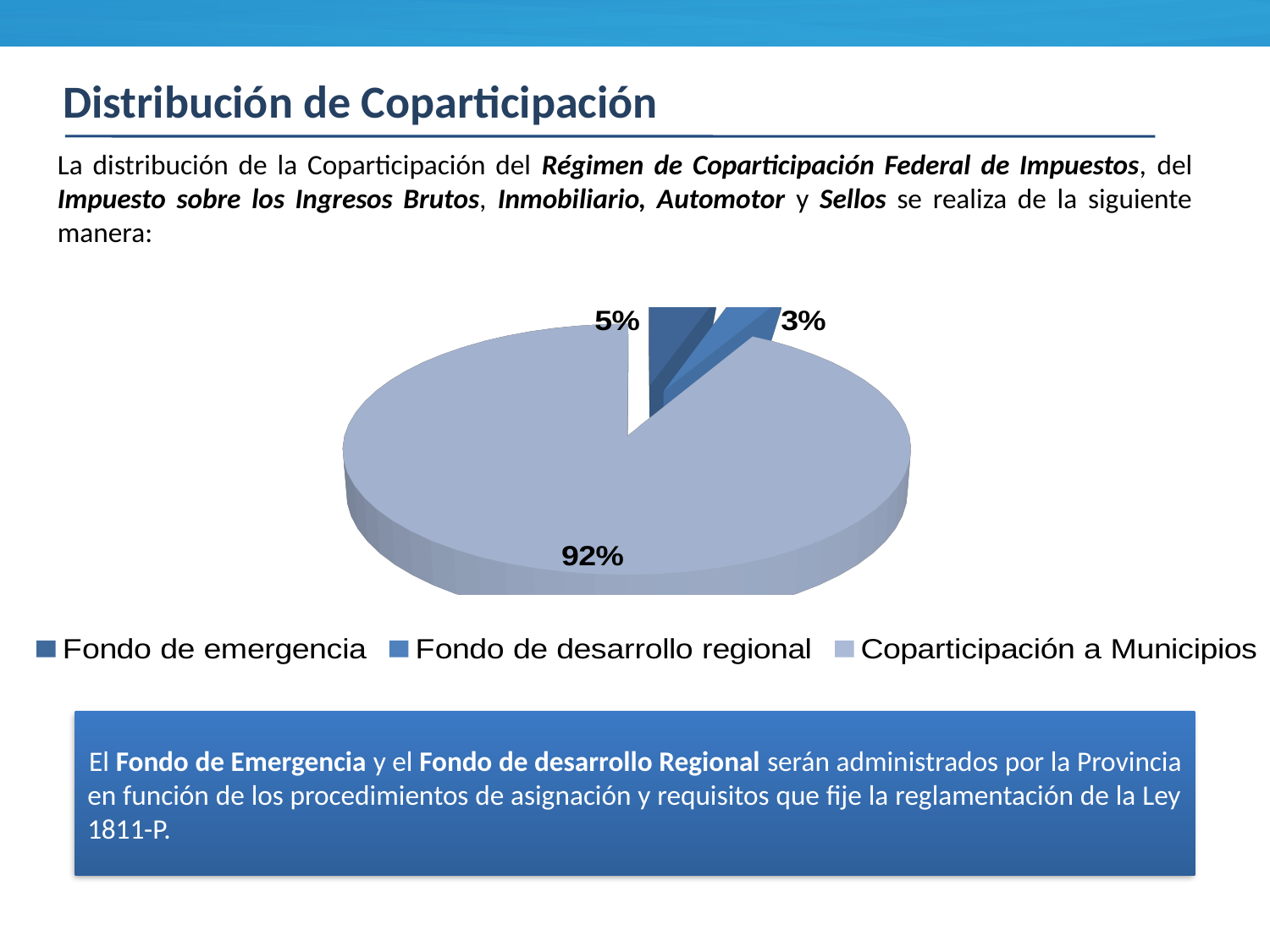
Which is larger, the slice for Fondo de emergencia or the slice for Fondo de desarrollo regional? Fondo de emergencia What is the difference in percentage points between Fondo de emergencia and Fondo de desarrollo regional? 2% How many slices does the pie chart have? 3 What share of the pie does Fondo de desarrollo regional represent? 3% What share of the pie does Coparticipación a Municipios represent? 92% What is the combined share of Fondo de emergencia and Fondo de desarrollo regional? 8% What share of the pie does Fondo de emergencia represent? 5% Which legend entry is shown in the lightest blue colour? Coparticipación a Municipios What kind of chart is shown on the slide? pie chart Which category has the largest slice of the pie? Coparticipación a Municipios Which category has the smallest slice of the pie? Fondo de desarrollo regional How many entries does the legend list? 3